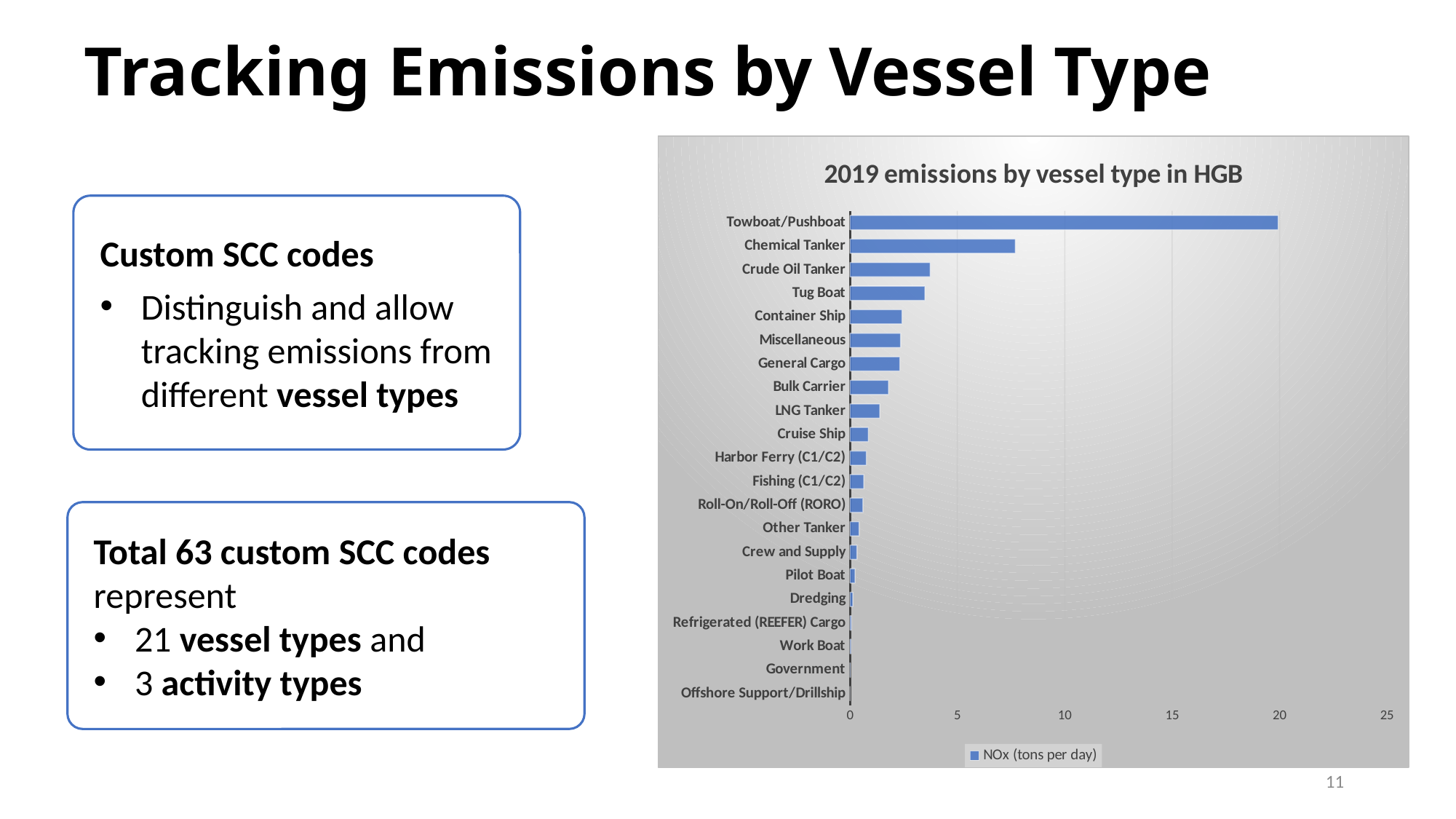
How many series does the legend list? 1 Is the value for Crude Oil Tanker greater or less than 5? less How many vessel types are plotted in the chart? 21 Which has higher NOx emissions, Tug Boat or Container Ship? Tug Boat What type of chart is shown on the slide? bar chart What series does the chart legend list? NOx (tons per day) What is the title of the chart? 2019 emissions by vessel type in HGB Which has higher NOx emissions, Chemical Tanker or Crude Oil Tanker? Chemical Tanker Is the value for Chemical Tanker greater or less than 5? greater Which has higher NOx emissions, Cruise Ship or Crude Oil Tanker? Crude Oil Tanker Is the value for Towboat/Pushboat greater or less than 15? greater Which vessel type has the highest NOx emissions? Towboat/Pushboat